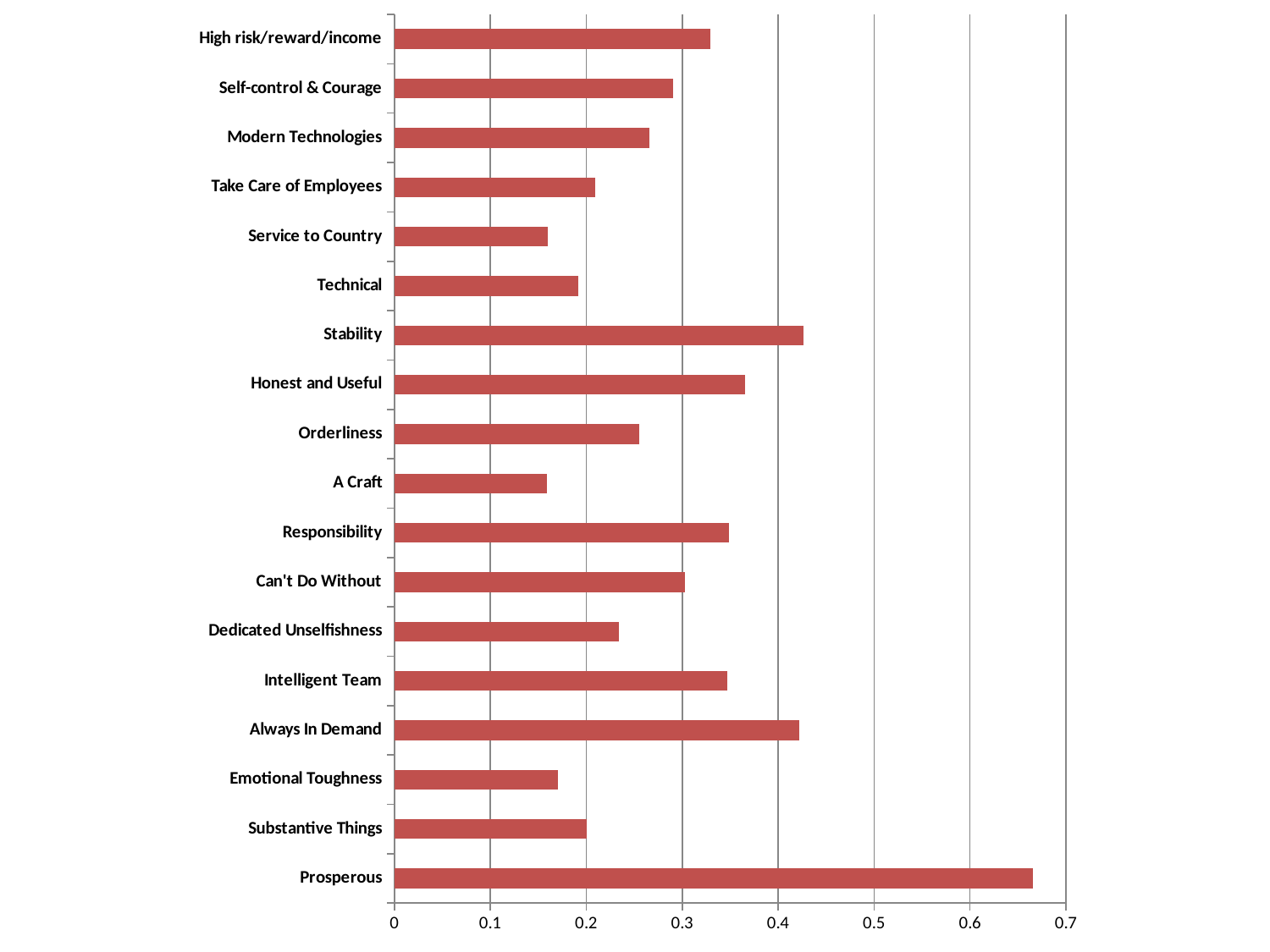
Which has a larger value, Prosperous or Stability? Prosperous What kind of chart is shown on the slide? bar chart Is the value for Emotional Toughness greater or less than 0.2? less Which has a larger value, Honest and Useful or Orderliness? Honest and Useful Is the value for Honest and Useful greater or less than 0.4? less Is the value for Prosperous greater or less than 0.6? greater Which has a larger value, Take Care of Employees or Service to Country? Take Care of Employees What is the highest value shown on the horizontal axis of the chart? 0.7 Which category has the highest value in the chart? Prosperous How many categories are plotted in the chart? 18